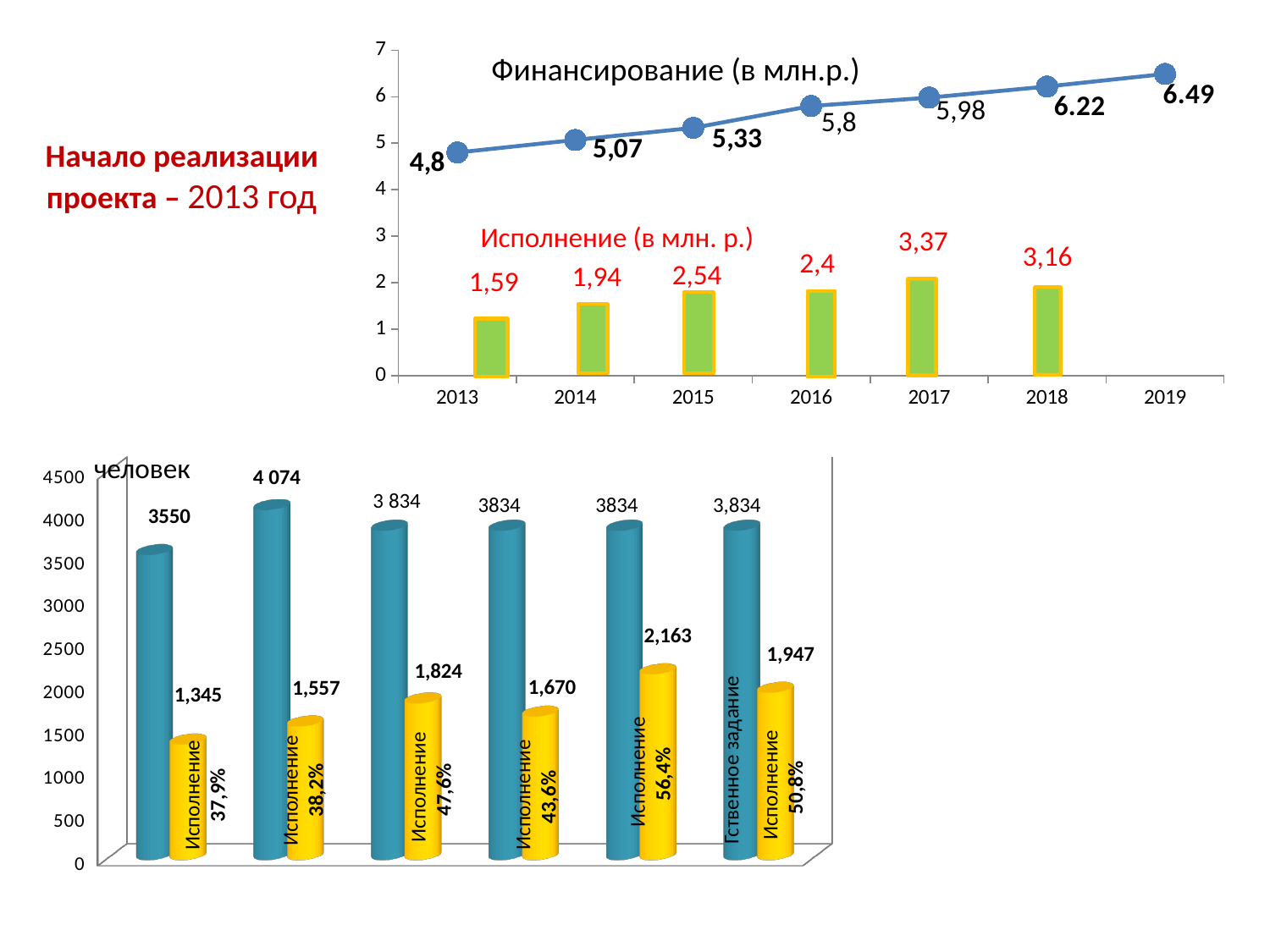
In the top chart, which year has the highest Исполнение value? 2017 In the bottom chart, how many teal (blue) bars are there? 6 In the top chart, which year has the larger Исполнение value, 2015 or 2016? 2015 In the top chart, is the Финансирование value for 2013 greater or less than 5? less In the top chart, which year has the lowest Исполнение value? 2013 In the top chart, what is the difference between the Исполнение values for 2017 and 2018? 0,21 In the top chart, does the Финансирование line rise or fall from 2013 to 2019? rises In the top chart, what is the Финансирование value for 2019? 6.49 In the bottom chart, what is the highest value shown on a yellow bar? 2,163 In the top chart, what is the Исполнение value for 2017? 3,37 In the top chart, what is the Финансирование value for 2016? 5,8 In the top chart, how many years are shown on the x axis? 7